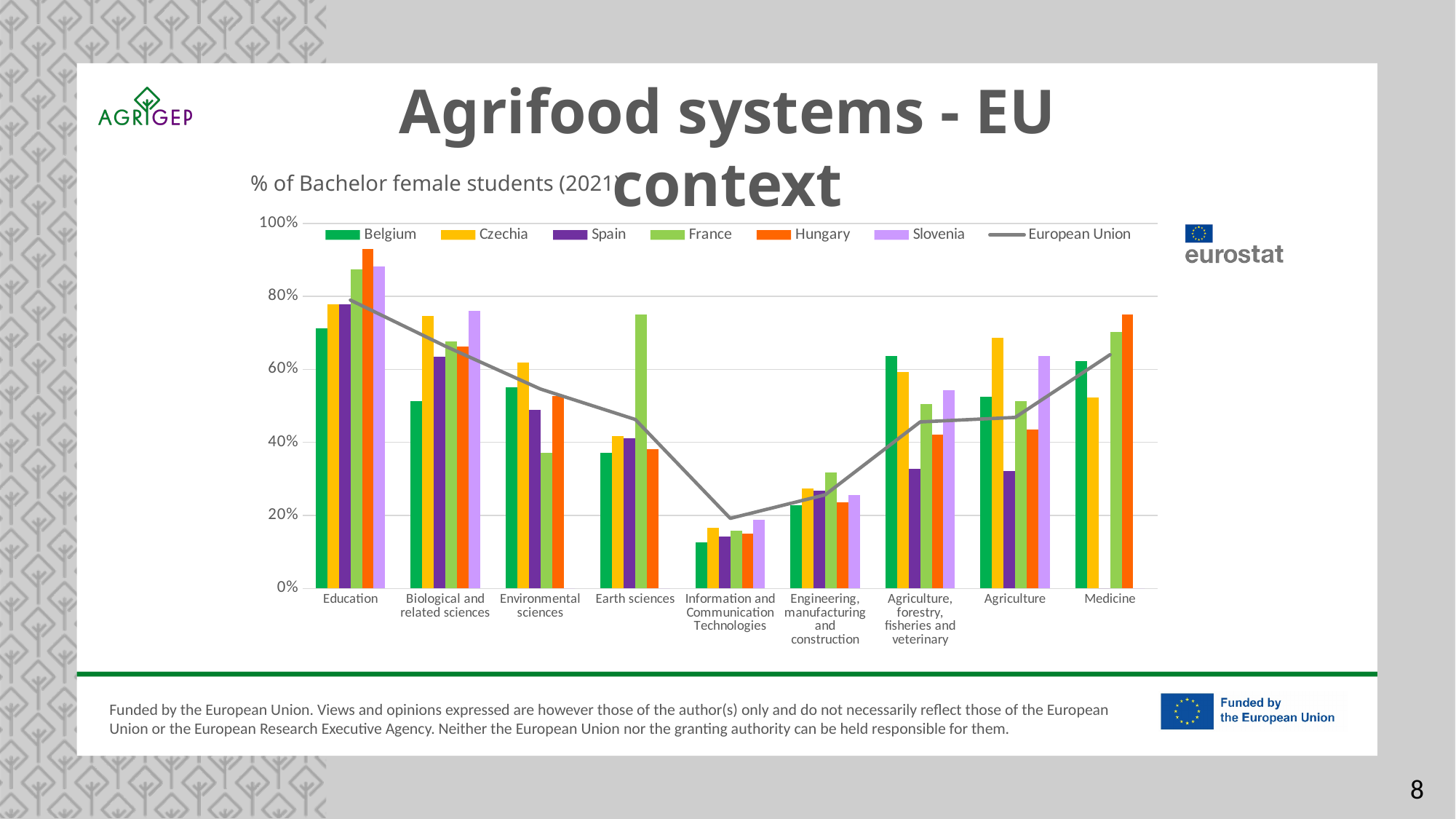
In Earth sciences, which is larger: the value for France or the value for Belgium? France What kind of chart is shown on the slide? combination bar and line chart How many series does the legend list? 7 How many fields of study are shown along the x axis? 9 Is the value for Hungary in Education greater or less than 80%? greater Is the value for France in Earth sciences greater or less than 60%? greater Is the value for Belgium in Information and Communication Technologies greater or less than 20%? less Does the European Union line rise or fall from Education to Information and Communication Technologies? fall In which field of study is the Hungary bar the highest? Education What is the subtitle printed above the chart? % of Bachelor female students (2021) In which field of study is the European Union line at its lowest point? Information and Communication Technologies In Agriculture, which is larger: the value for Czechia or the value for Belgium? Czechia